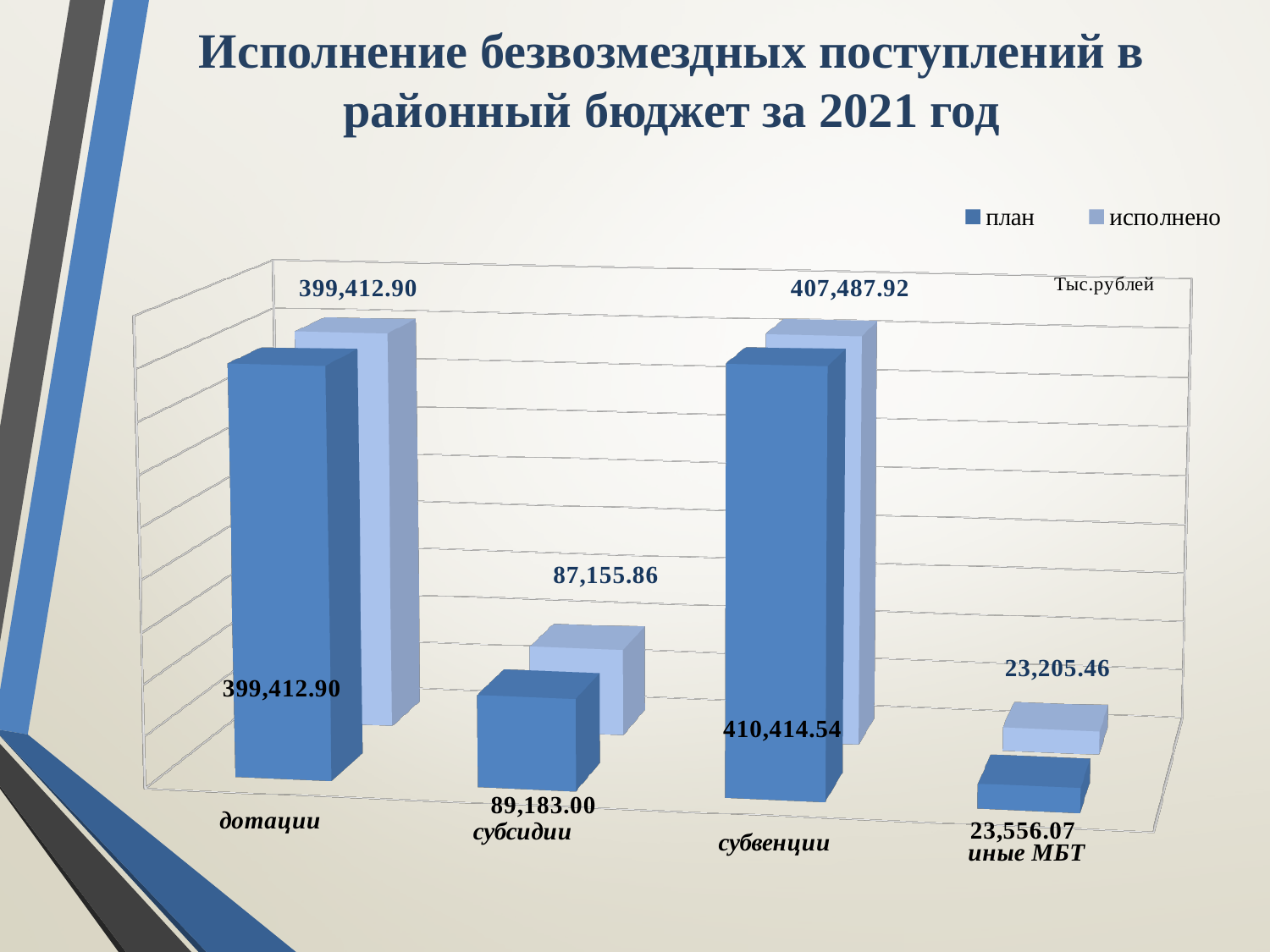
What is the исполнено value for субвенции? 407,487.92 What is the difference between the план and исполнено values for субсидии? 2,027.14 What is the исполнено value for иные МБТ? 23,205.46 What is the difference between the план and исполнено values for субвенции? 2,926.62 How many series does the legend list? 2 What is the план value for субсидии? 89,183.00 Which is larger: the план value for субвенции or the план value for дотации? субвенции What kind of chart is shown on the slide? bar chart Which category has the lowest план value? иные МБТ What is the план value for дотации? 399,412.90 How many categories are shown on the x axis? 4 Which category has the highest исполнено value? субвенции